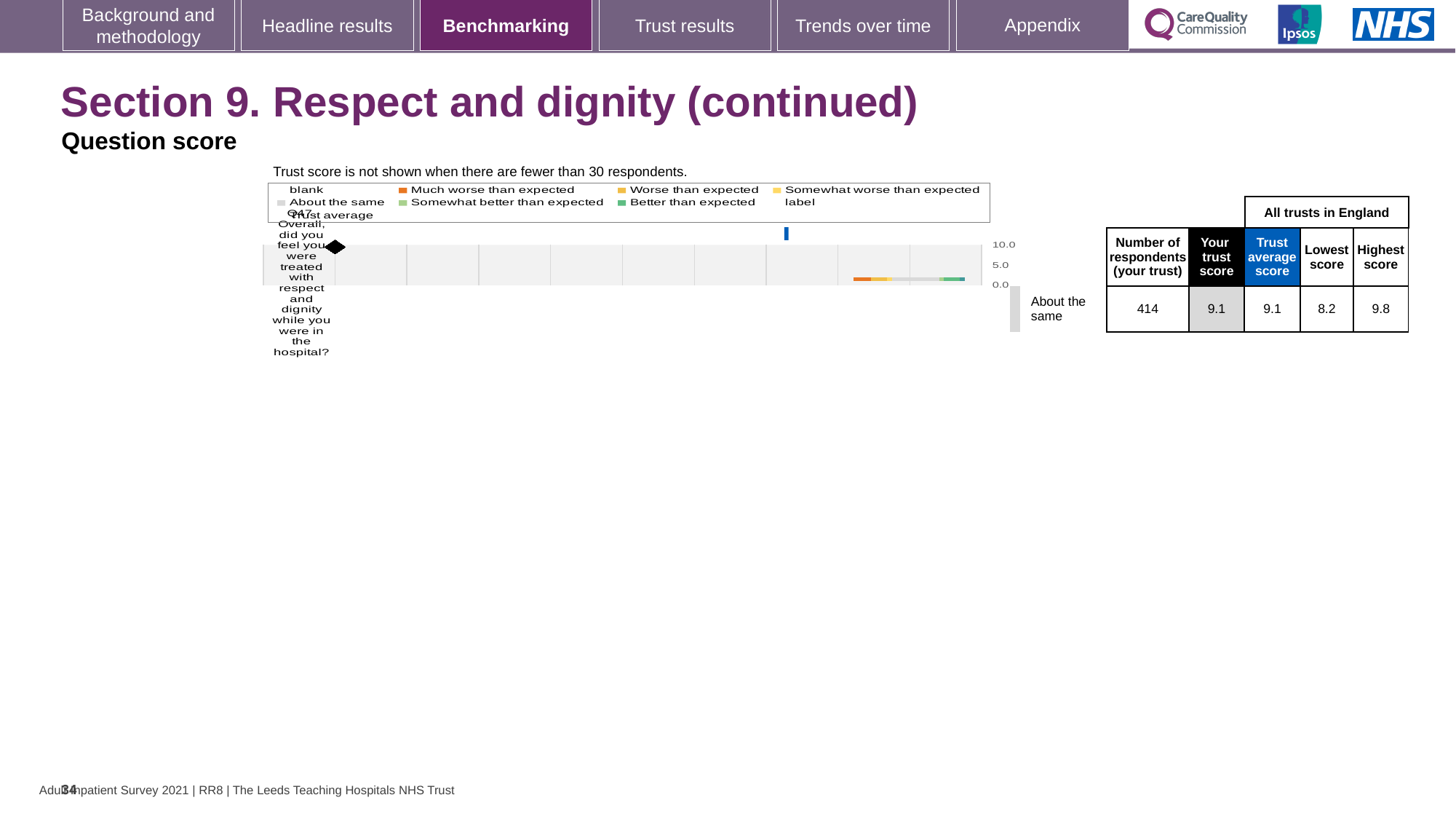
Is the trust average marker for Q47 greater or less than 5.0? greater Which benchmark category is Q47 assigned to for this trust? About the same What is your trust score for Q47? 9.1 What is the lowest score for Q47 among all trusts in England? 8.2 How many survey questions are plotted in the chart? 1 What is the difference between the highest score and the lowest score for Q47? 1.6 What kind of chart is shown on the slide? bar chart What is the number of respondents for Q47 at your trust? 414 What is the maximum value shown on the chart's score axis? 10.0 What is the highest score for Q47 among all trusts in England? 9.8 Which question number is plotted in the chart? Q47 What is the trust average score for Q47 across all trusts in England? 9.1